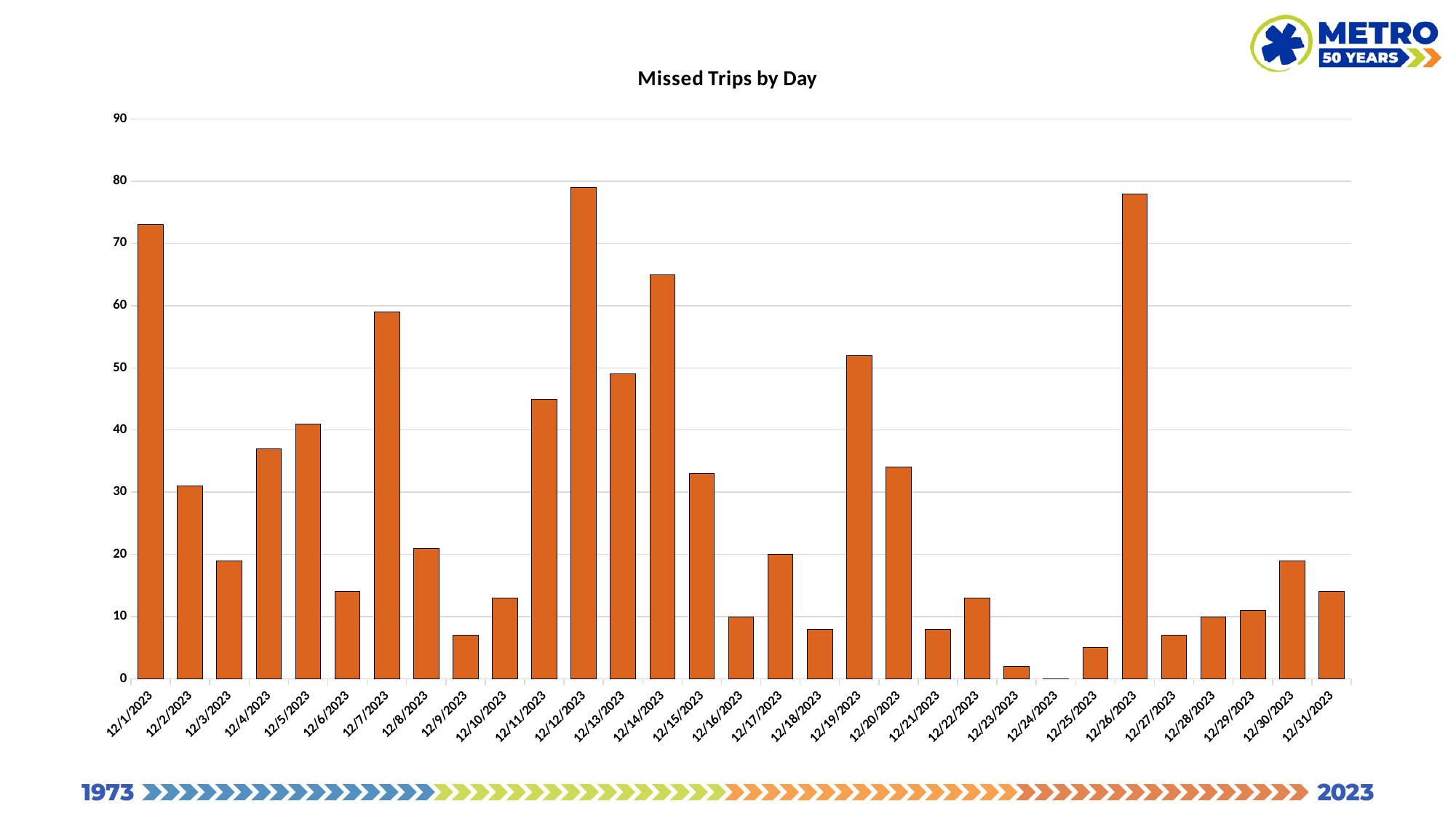
Is the value for 12/9/2023 greater or less than 10? less How many days (bars) are plotted on the chart? 31 Which day has more missed trips, 12/12/2023 or 12/13/2023? 12/12/2023 Is the value for 12/4/2023 greater or less than 30? greater Is the value for 12/1/2023 greater or less than 60? greater Which day has more missed trips, 12/7/2023 or 12/8/2023? 12/7/2023 What kind of chart is shown on the slide? bar chart Which day has the lowest number of missed trips? 12/24/2023 What is the title of the chart? Missed Trips by Day Which day has more missed trips, 12/26/2023 or 12/27/2023? 12/26/2023